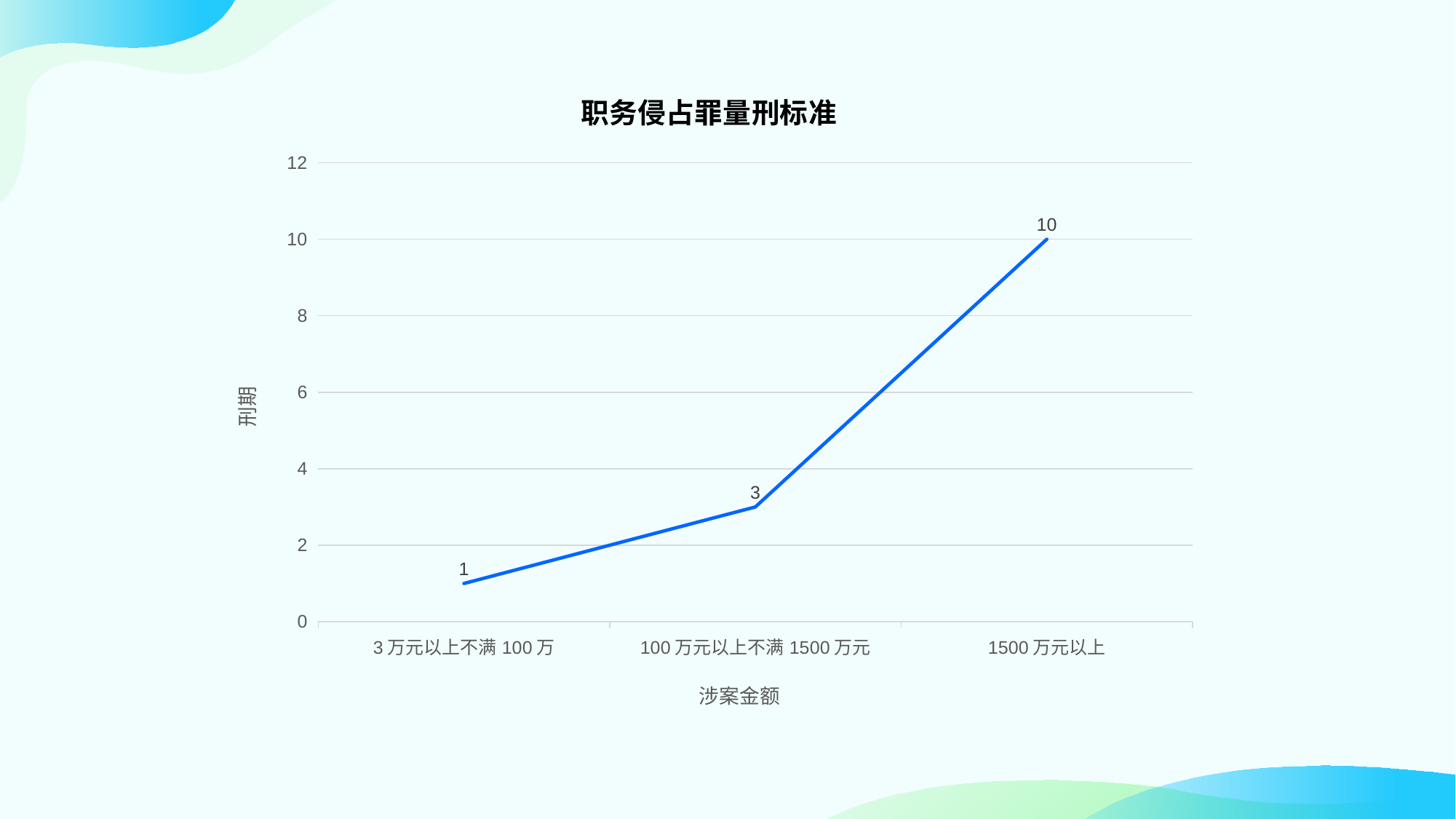
What is the difference in 刑期 between 100 万元以上不满 1500 万元 and 3 万元以上不满 100 万? 2 What is the 刑期 value for 3 万元以上不满 100 万? 1 What is the title of the chart? 职务侵占罪量刑标准 How many 涉案金额 categories are plotted on the chart? 3 Which 涉案金额 category has the highest 刑期? 1500 万元以上 Do the 刑期 values rise or fall as 涉案金额 increases along the x axis? Rise Which has a larger 刑期: 100 万元以上不满 1500 万元 or 3 万元以上不满 100 万? 100 万元以上不满 1500 万元 What is the difference in 刑期 between 1500 万元以上 and 100 万元以上不满 1500 万元? 7 What is the 刑期 value for 100 万元以上不满 1500 万元? 3 Which 涉案金额 category has the lowest 刑期? 3 万元以上不满 100 万 What kind of chart is shown on the slide? Line chart What is the 刑期 value for 1500 万元以上? 10